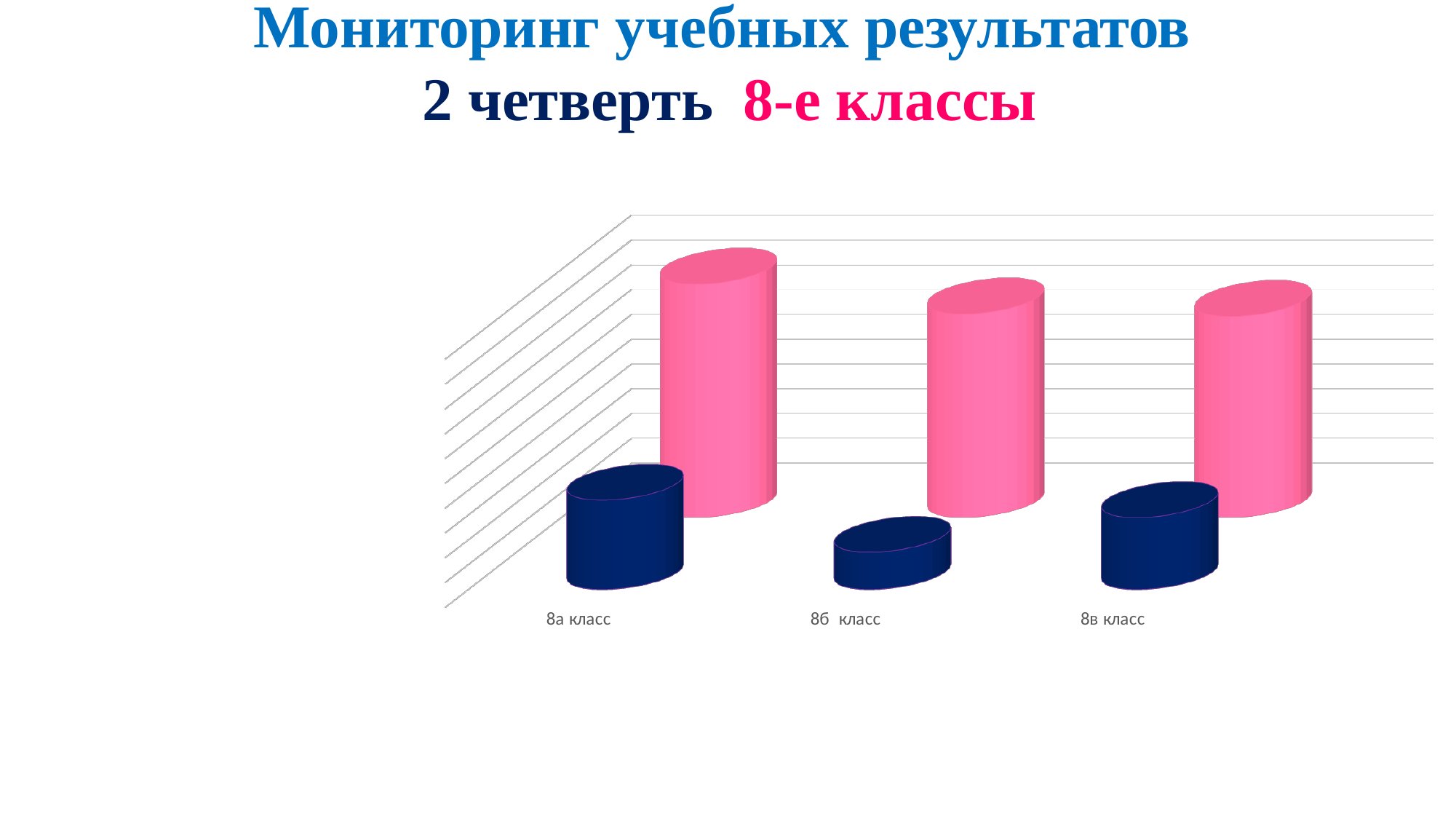
What is the label of the middle category on the x axis? 8б класс How many categories are shown on the x axis of the chart? 3 For 8а класс, which bar is taller, the pink one or the dark blue one? the pink one What two colours are used for the bars in the chart? pink and dark blue For 8б класс, which bar is shorter, the pink one or the dark blue one? the dark blue one How many bars are plotted for each class in the chart? 2 Is the pink bar for 8а класс taller or shorter than the pink bar for 8б класс? taller Which class has the tallest pink bar? 8а класс What kind of chart is shown on the slide? bar chart Which class has the shortest dark blue bar? 8б класс